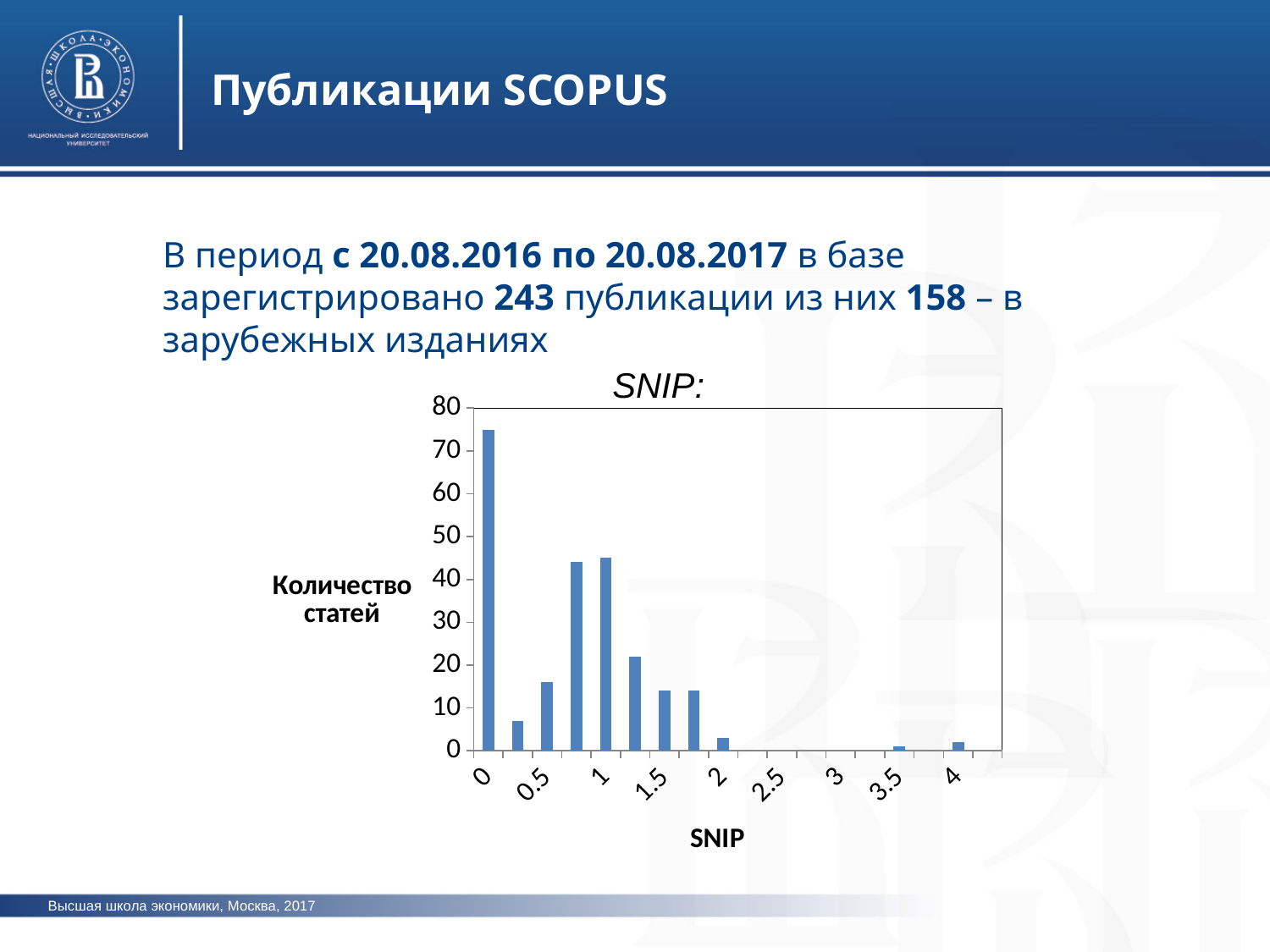
Which SNIP value has the highest number of articles? 0 Is the value for SNIP 0.5 greater or less than 20? less Which has more articles, SNIP 0 or SNIP 1? SNIP 0 What is the title of the chart? SNIP: Which has more articles, SNIP 1.5 or SNIP 2? SNIP 1.5 Is the value for SNIP 1.5 greater or less than 20? less Is the value for SNIP 0 greater or less than 70? greater What kind of chart is shown on the slide? bar chart What is the label of the vertical axis of the chart? Количество статей